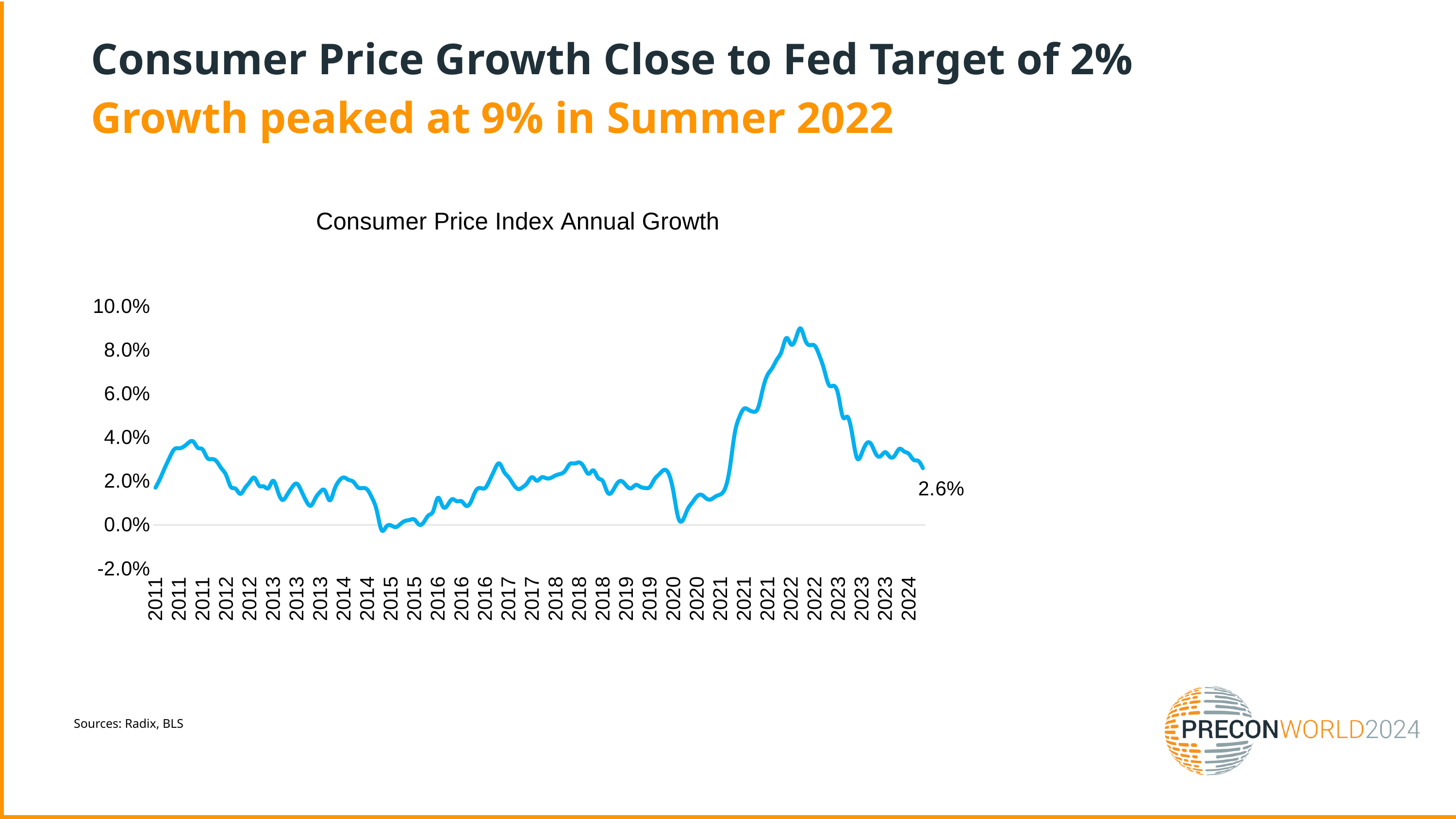
Does the line rise or fall from 2020 to 2022? rise What is the highest value shown on the y axis? 10.0% Does the line rise or fall from its 2022 peak to 2024? fall Is the value of the line in 2022 larger than the value in 2011? yes In which year does the line reach its highest point? 2022 Is the value of the line at the start of 2015 greater or less than 2.0%? less What is the first year shown on the x axis? 2011 What is the title of the chart? Consumer Price Index Annual Growth What is the value shown by the data label at the end of the line in 2024? 2.6% What kind of chart is shown on the slide? line chart Is the peak value of the line in 2022 greater or less than 8.0%? greater